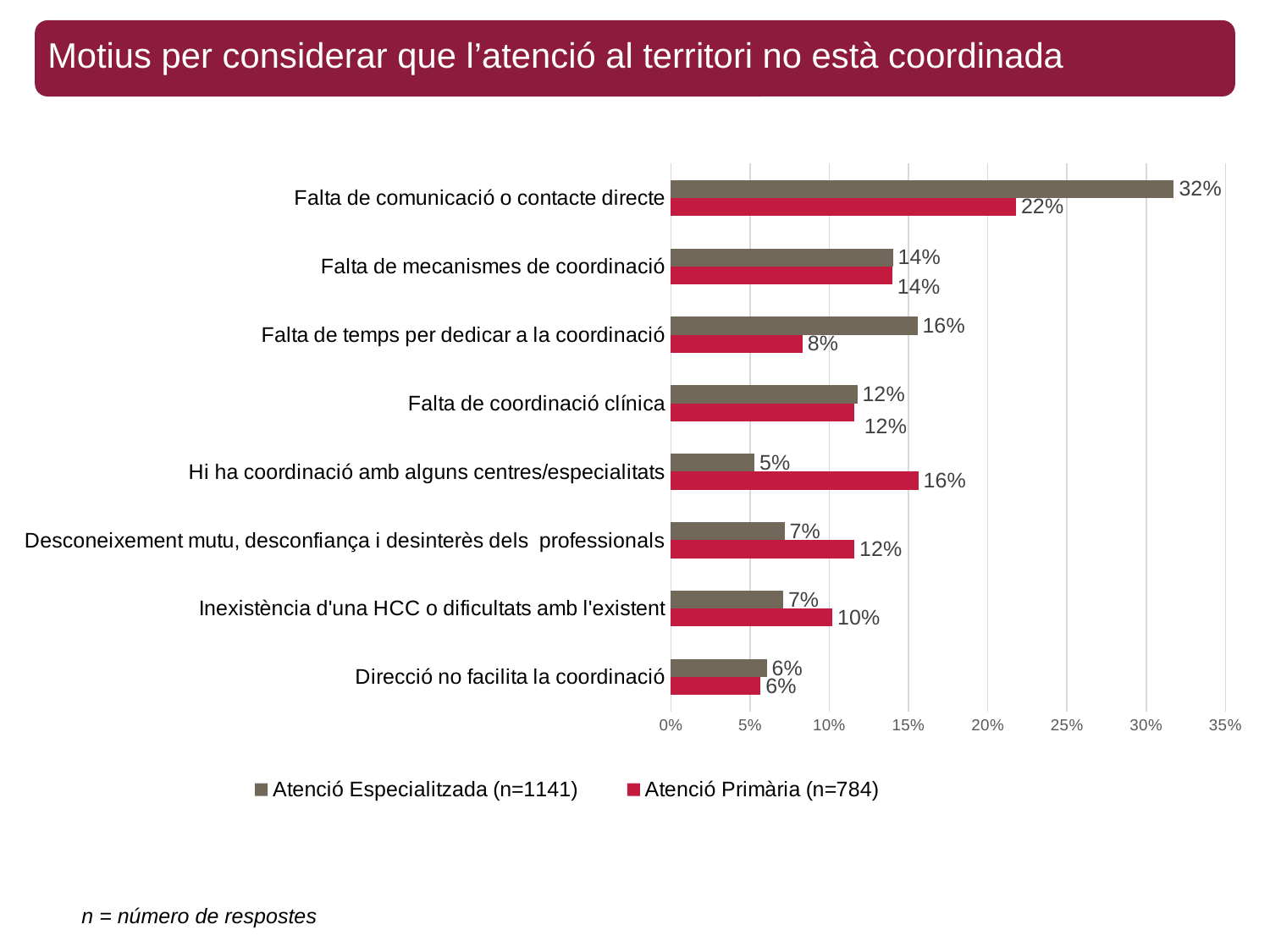
Which category has the lowest value for Atenció Especialitzada? Hi ha coordinació amb alguns centres/especialitats What is the title of the chart? Motius per considerar que l'atenció al territori no està coordinada What is the difference between the Atenció Especialitzada and Atenció Primària values for 'Falta de comunicació o contacte directe'? 10% What is the value for Atenció Primària for 'Hi ha coordinació amb alguns centres/especialitats'? 16% What is the value for Atenció Especialitzada for 'Falta de comunicació o contacte directe'? 32% Which category has the highest value for Atenció Especialitzada? Falta de comunicació o contacte directe Is the Atenció Primària value for 'Falta de comunicació o contacte directe' greater or less than 20%? greater For 'Desconeixement mutu, desconfiança i desinterès dels professionals', which series has the larger value? Atenció Primària (n=784) How many categories are shown on the chart? 8 What is the value for Atenció Primària for 'Falta de temps per dedicar a la coordinació'? 8% What kind of chart is shown on the slide? Bar chart How many series does the legend list? 2